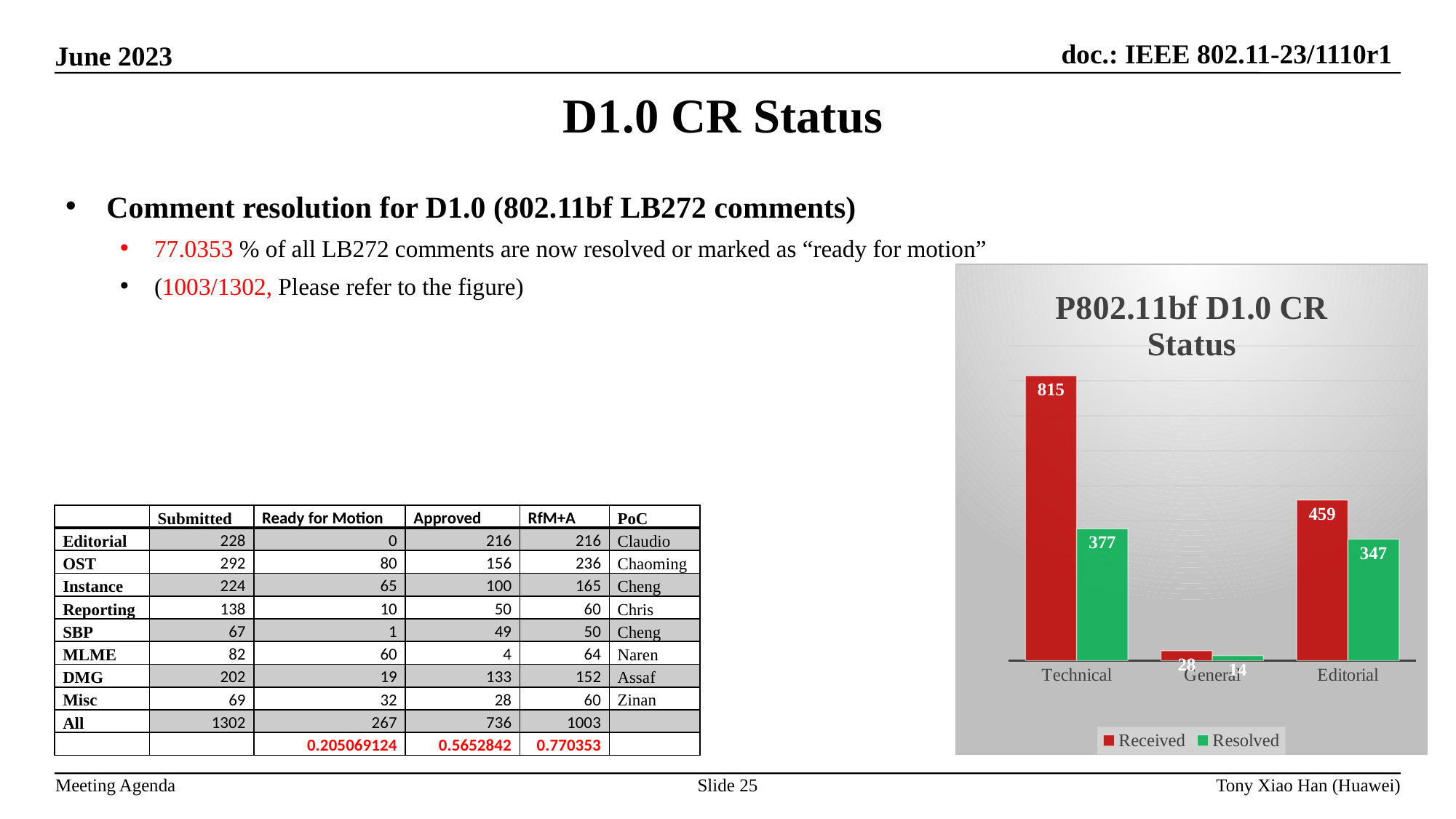
What kind of chart is shown? Bar chart Which category has the lowest Resolved value? General How many series does the legend list? 2 Which category has the highest Received value? Technical What is the Received value for Technical? 815 Which is larger, the Resolved value for Technical or the Resolved value for Editorial? Technical What is the difference between Received and Resolved for Editorial? 112 What is the Received value for General? 28 What is the Resolved value for Editorial? 347 How many categories are shown on the x axis? 3 What is the Resolved value for Technical? 377 What is the difference between Received and Resolved for Technical? 438